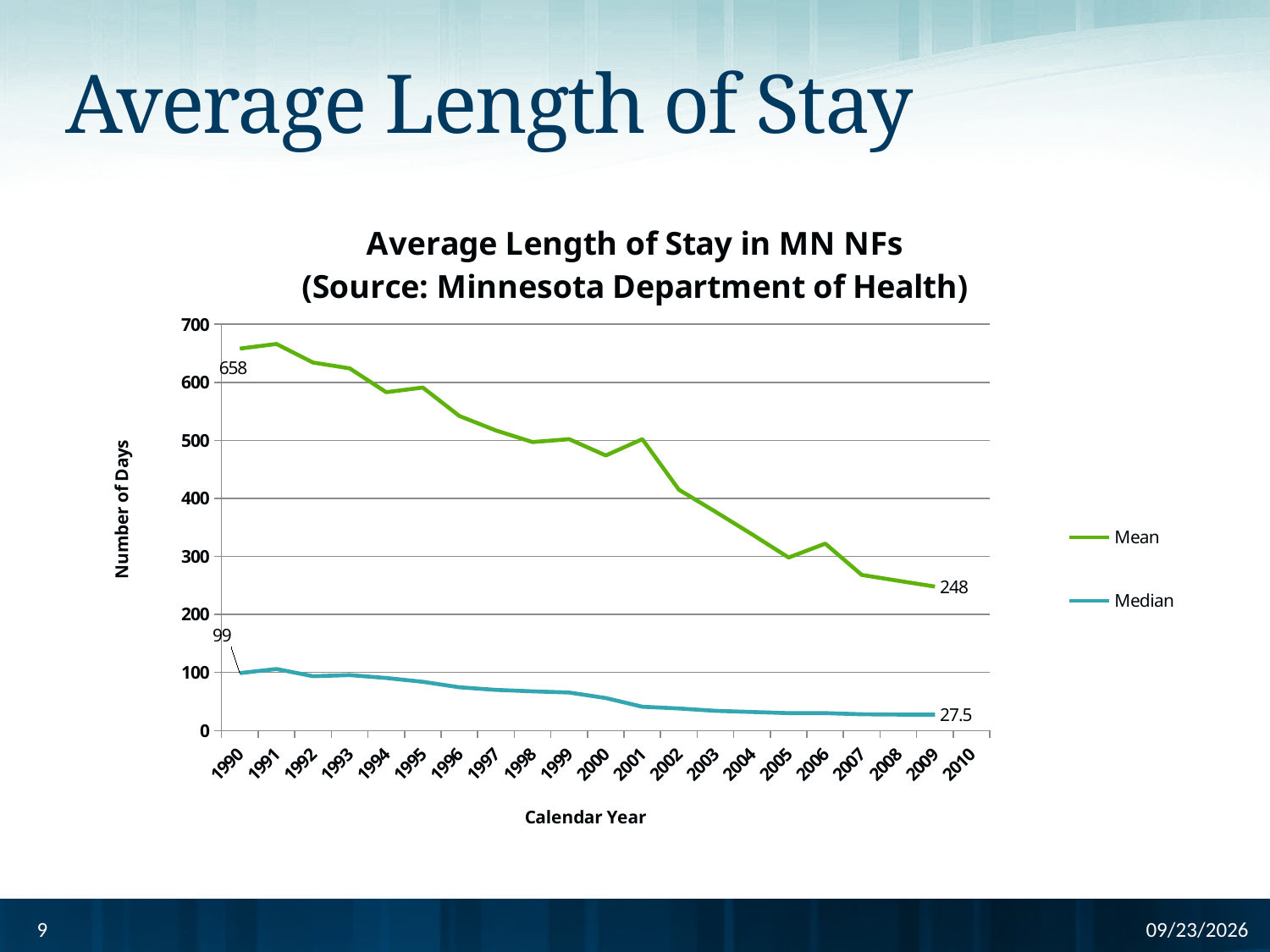
By how many days did the Median length of stay fall from 1990 to 2009? 71.5 Which series has the higher value in 2000, Mean or Median? Mean What is the label on the vertical axis? Number of Days What type of chart is shown on the slide? Line chart Does the Mean length of stay rise or fall over the years shown? Fall What is the Mean average length of stay in 1990? 658 What is the Mean average length of stay in 2009? 248 What is the Median length of stay in 1990? 99 What is the Median length of stay in 2009? 27.5 By how many days did the Mean length of stay fall from 1990 to 2009? 410 How many series does the legend list? 2